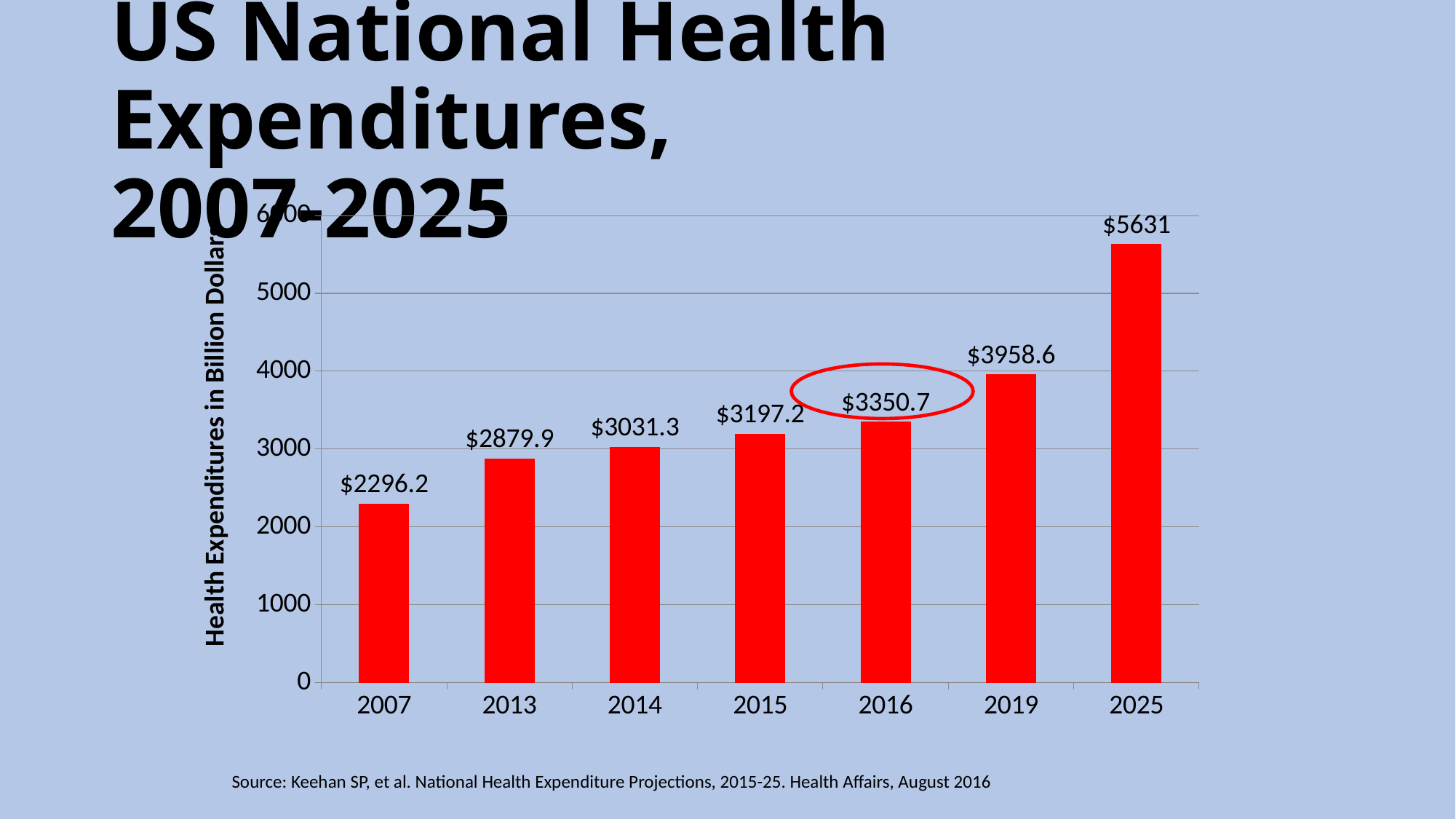
What is the value for 2025? $5631 How many years are shown on the x axis? 7 What is the value for 2016? $3350.7 Which is larger, the value for 2015 or the value for 2016? 2016 Which year has the highest health expenditures? 2025 What kind of chart is shown on the slide? bar chart What is the value for 2019? $3958.6 Is the value for 2019 greater or less than 4000? less Which year has the lowest health expenditures? 2007 What is the value for 2007? $2296.2 What is the difference between the values for 2025 and 2019? $1672.4 What is the difference between the values for 2014 and 2013? $151.4